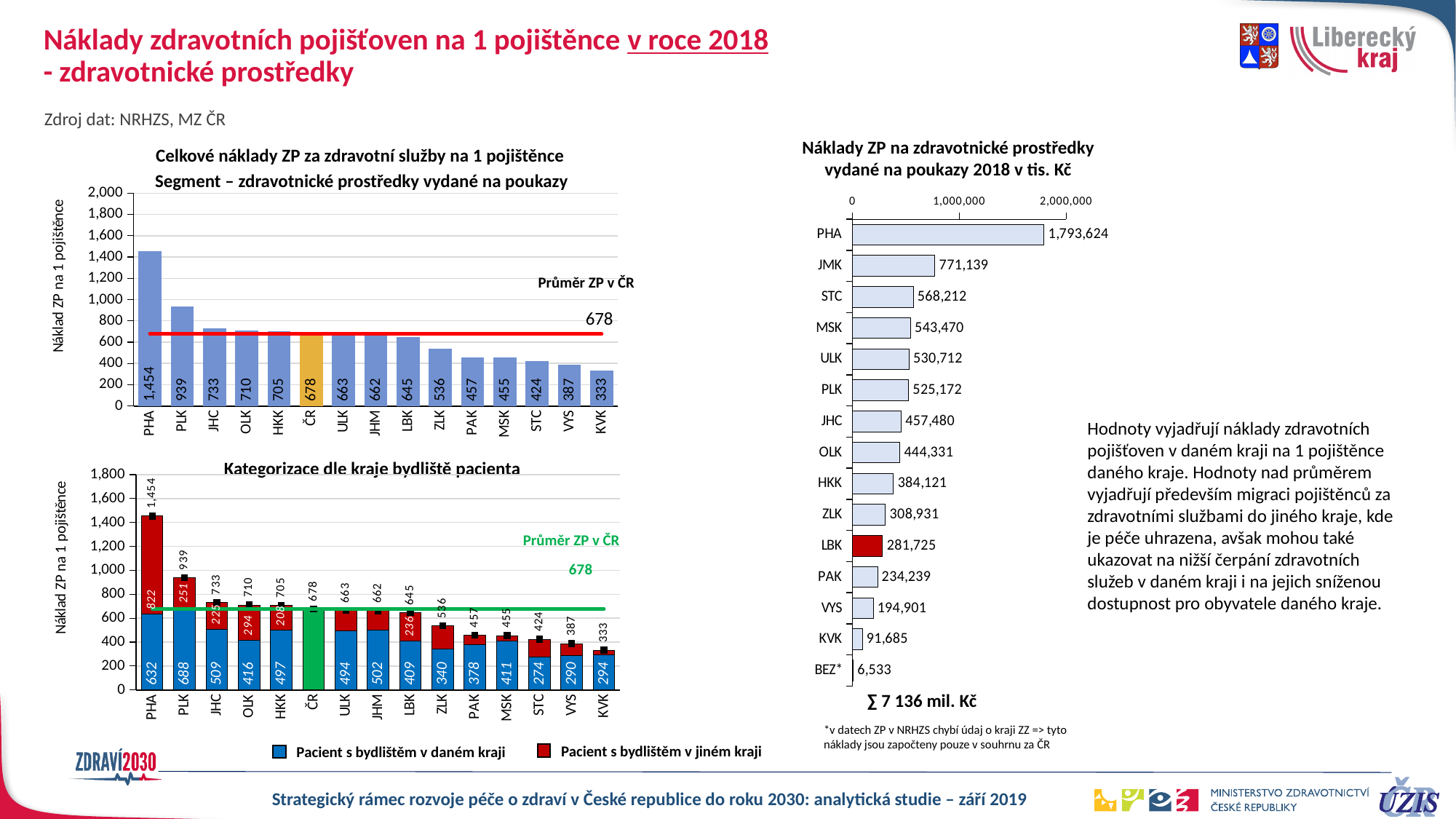
In the bottom-left chart 'Kategorizace dle kraje bydliště pacienta', what is the total of the stacked bar for LBK? 645 In the bottom-left chart 'Kategorizace dle kraje bydliště pacienta', how many series does the legend list? 2 In the bottom-left chart 'Kategorizace dle kraje bydliště pacienta', what is the value of the 'Pacient s bydlištěm v daném kraji' segment for PLK? 688 In the top-left chart 'Celkové náklady ZP za zdravotní služby na 1 pojištěnce', which category has the lowest value? KVK In the top-left chart 'Celkové náklady ZP za zdravotní služby na 1 pojištěnce', what is the difference between PLK and JHC? 206 In the right chart 'Náklady ZP na zdravotnické prostředky vydané na poukazy 2018 v tis. Kč', which category has the highest value? PHA In the top-left chart 'Celkové náklady ZP za zdravotní služby na 1 pojištěnce', how many categories are shown on the x axis? 15 In the bottom-left chart 'Kategorizace dle kraje bydliště pacienta', what is the value of the 'Pacient s bydlištěm v jiném kraji' segment for PHA? 822 What kind of chart is the right chart 'Náklady ZP na zdravotnické prostředky vydané na poukazy 2018 v tis. Kč'? Bar chart In the right chart 'Náklady ZP na zdravotnické prostředky vydané na poukazy 2018 v tis. Kč', what is the value for LBK? 281,725 In the top-left chart 'Celkové náklady ZP za zdravotní služby na 1 pojištěnce', what is the value for PHA? 1,454 In the top-left chart 'Celkové náklady ZP za zdravotní služby na 1 pojištěnce', what is the value for LBK? 645